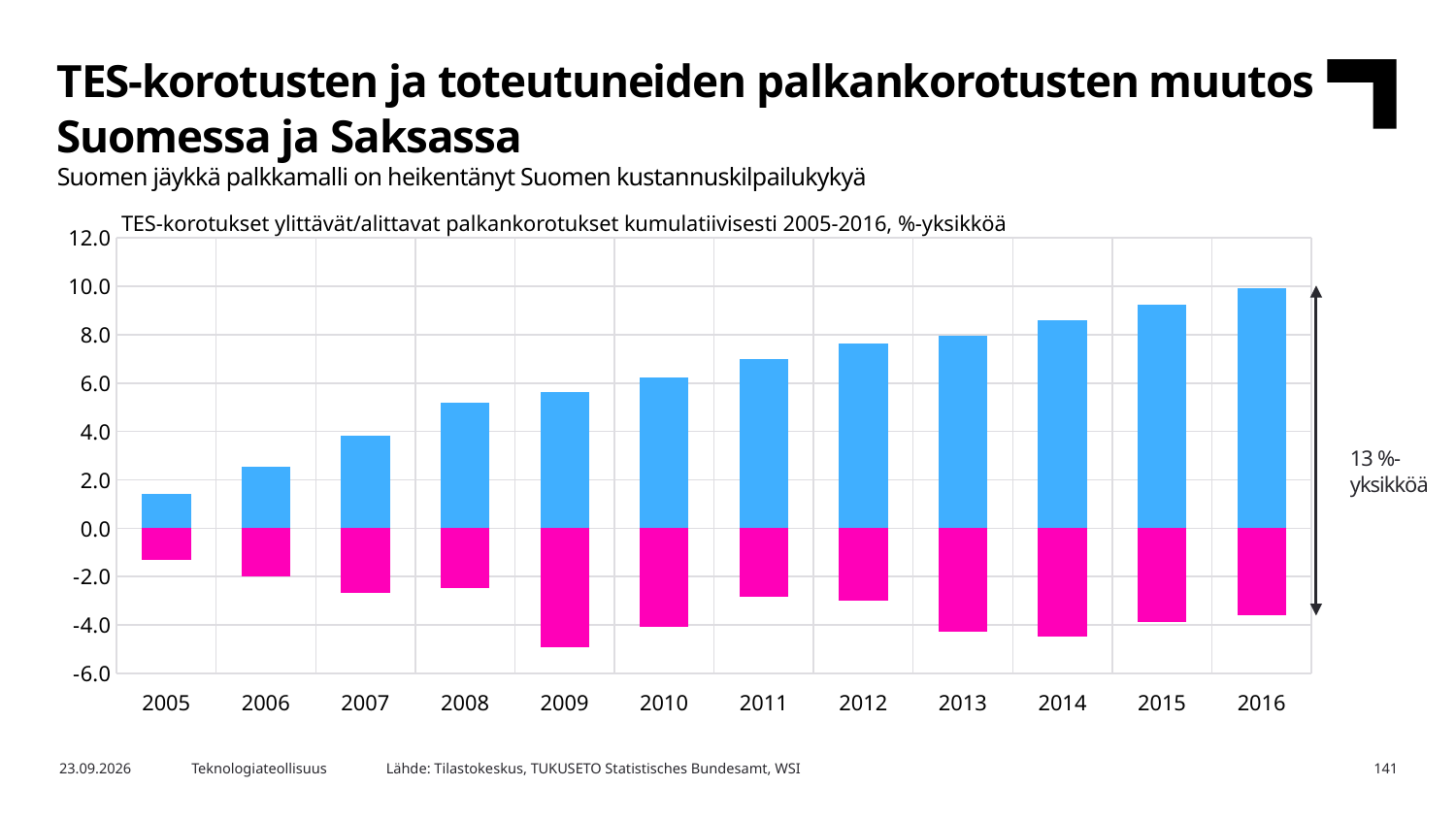
Is the blue bar for 2005 greater or less than 2.0? less Do the blue bars rise or fall from 2005 to 2016? rise Is the blue bar for 2016 greater or less than 8.0? greater What kind of chart is shown on the slide? bar chart Is the blue bar for 2012 greater or less than 8.0? less Which year has the larger blue bar, 2008 or 2014? 2014 Which year has the shortest blue (positive) bar? 2005 Which year has the tallest blue (positive) bar? 2016 What value does the annotation with the arrow on the right of the chart state? 13 %-yksikköä How many years are shown on the x axis of the chart? 12 Which year has the longest magenta (negative) bar? 2009